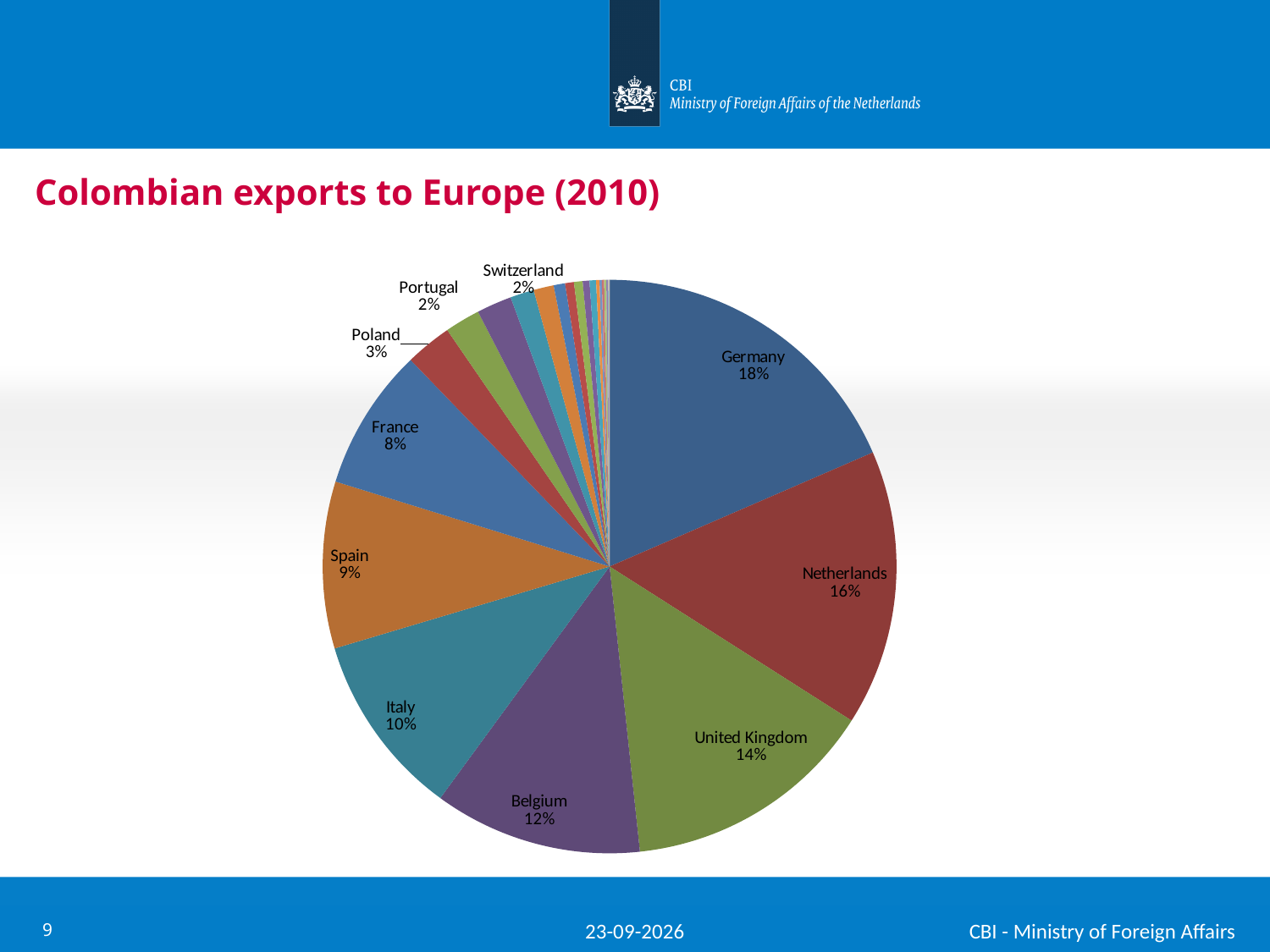
Which country has the largest slice of the pie? Germany What is the difference in percentage points between Germany's share and the Netherlands' share? 2 percentage points What percentage is shown for Spain? 9% What is the combined share of Portugal and Switzerland? 4% What percentage is shown for the United Kingdom? 14% What is the title of the chart? Colombian exports to Europe (2010) Which is larger, the share for Italy or the share for France? Italy What kind of chart is shown on the slide? pie chart What share of Colombian exports to Europe went to Germany? 18% What percentage is shown for Poland? 3% What percentage is shown for Belgium? 12% What percentage is shown for the Netherlands? 16%